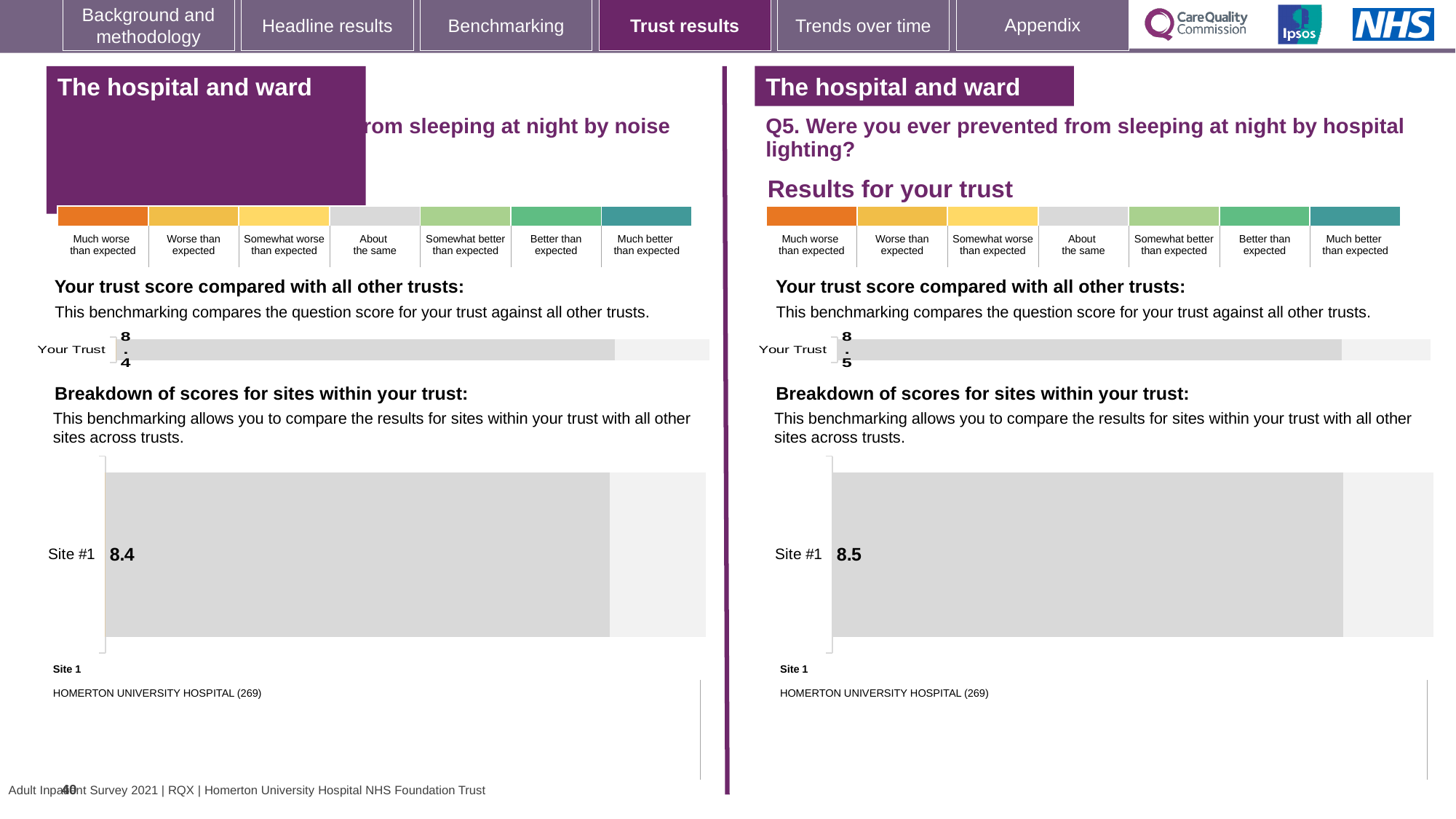
How many categories are shown in the colour scale legend above the right 'Your trust score compared with all other trusts' chart (Q5, hospital lighting)? 7 What is the difference between the Site #1 score in the right breakdown chart (Q5, hospital lighting) and the Site #1 score in the left breakdown chart? 0.1 How many sites are plotted in the left 'Breakdown of scores for sites within your trust' chart? 1 On the left half of the slide, what is the score shown for Your Trust in the 'Your trust score compared with all other trusts' chart? 8.4 Which is larger: the Your Trust score on the left half of the slide or the Your Trust score on the right half (Q5, hospital lighting)? Right (Q5, hospital lighting) On the right half of the slide (Q5, hospital lighting), what is the score shown for Your Trust in the 'Your trust score compared with all other trusts' chart? 8.5 Which hospital is listed as Site 1 beneath the right breakdown chart (Q5, hospital lighting)? HOMERTON UNIVERSITY HOSPITAL (269) What kind of chart is used in the 'Breakdown of scores for sites within your trust' section on the right half of the slide? Bar chart What kind of chart is used to show the Your Trust score on the left half of the slide? Bar chart In the right 'Breakdown of scores for sites within your trust' chart (Q5, hospital lighting), what is the score for Site #1? 8.5 How many sites are plotted in the right 'Breakdown of scores for sites within your trust' chart (Q5, hospital lighting)? 1 In the left 'Breakdown of scores for sites within your trust' chart, what is the score for Site #1? 8.4